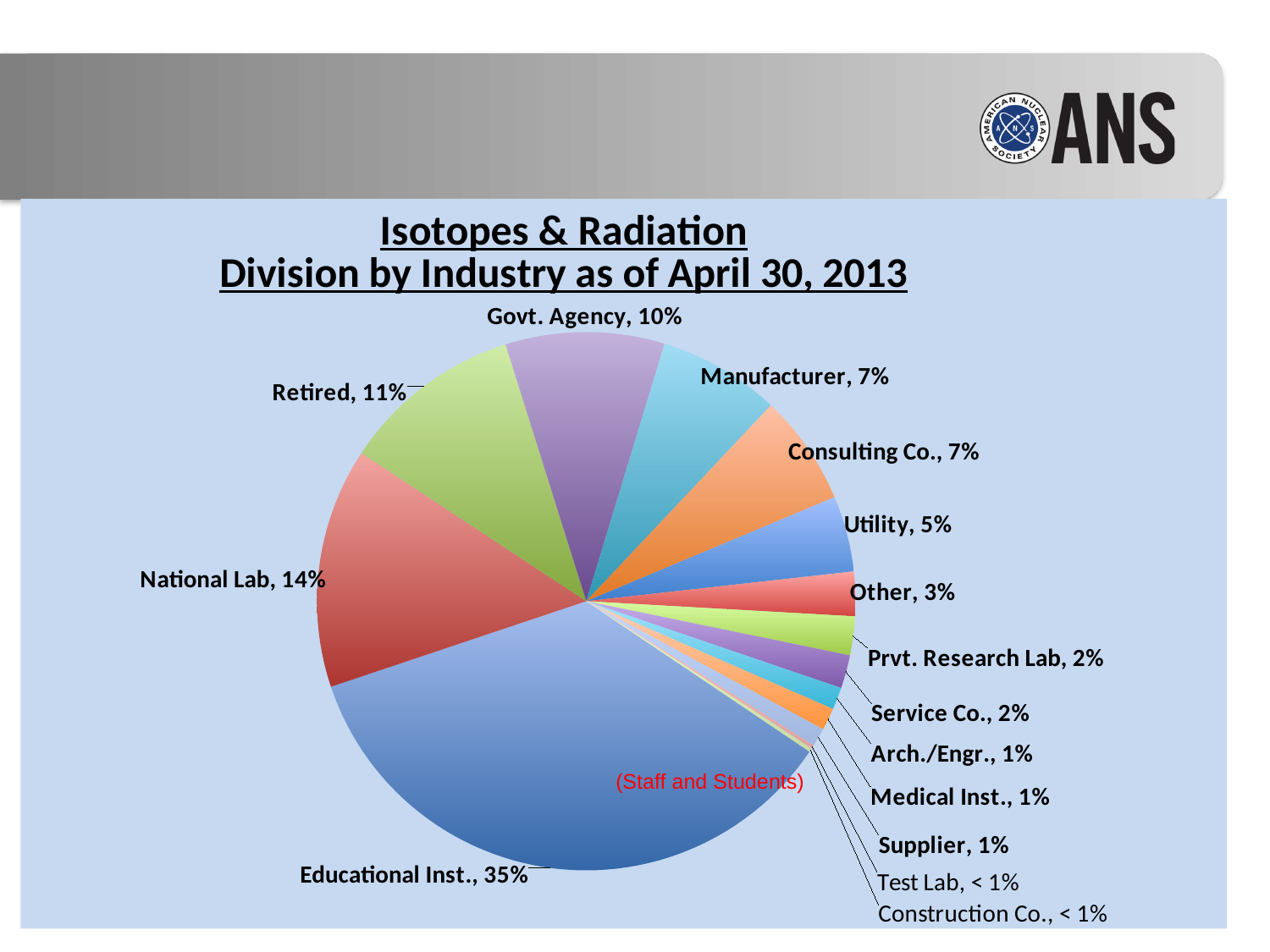
Which category has the largest slice of the pie? Educational Inst. How many categories are labelled on the pie chart? 15 What is the difference in percentage points between Educational Inst. and National Lab? 21 What is the title of the chart? Isotopes & Radiation Division by Industry as of April 30, 2013 What share of the pie does Educational Inst. hold? 35% Which is larger, the share for Other or the share for Utility? Utility What percentage is shown for Retired? 11% What percentage is shown for National Lab? 14% Which is larger, the share for Retired or the share for Govt. Agency? Retired What is the difference in percentage points between Govt. Agency and Utility? 5 What kind of chart is shown on the slide? Pie chart What percentage is shown for Utility? 5%